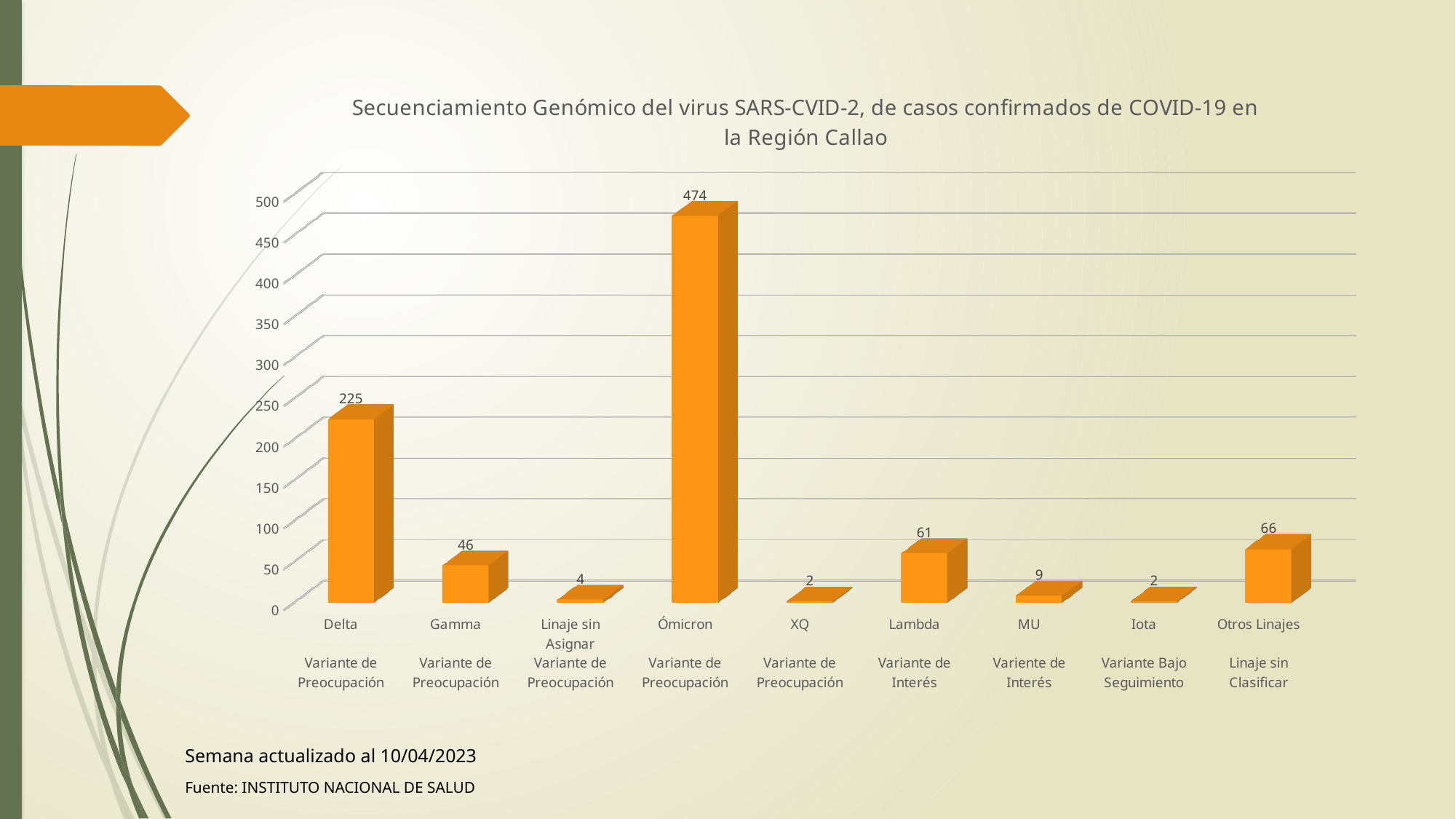
What kind of chart is shown on the slide? bar chart What is the difference between the values for Otros Linajes and Lambda? 5 What is the value for Lambda? 61 What is the source cited below the chart? INSTITUTO NACIONAL DE SALUD What is the value for Otros Linajes? 66 What is the value for Ómicron? 474 Is the value for Delta greater or less than 200? greater Which is larger, the value for Gamma or the value for MU? Gamma How many categories are shown on the x axis? 9 What is the difference between the values for Ómicron and Delta? 249 Which category has the highest value? Ómicron What is the value for Delta? 225